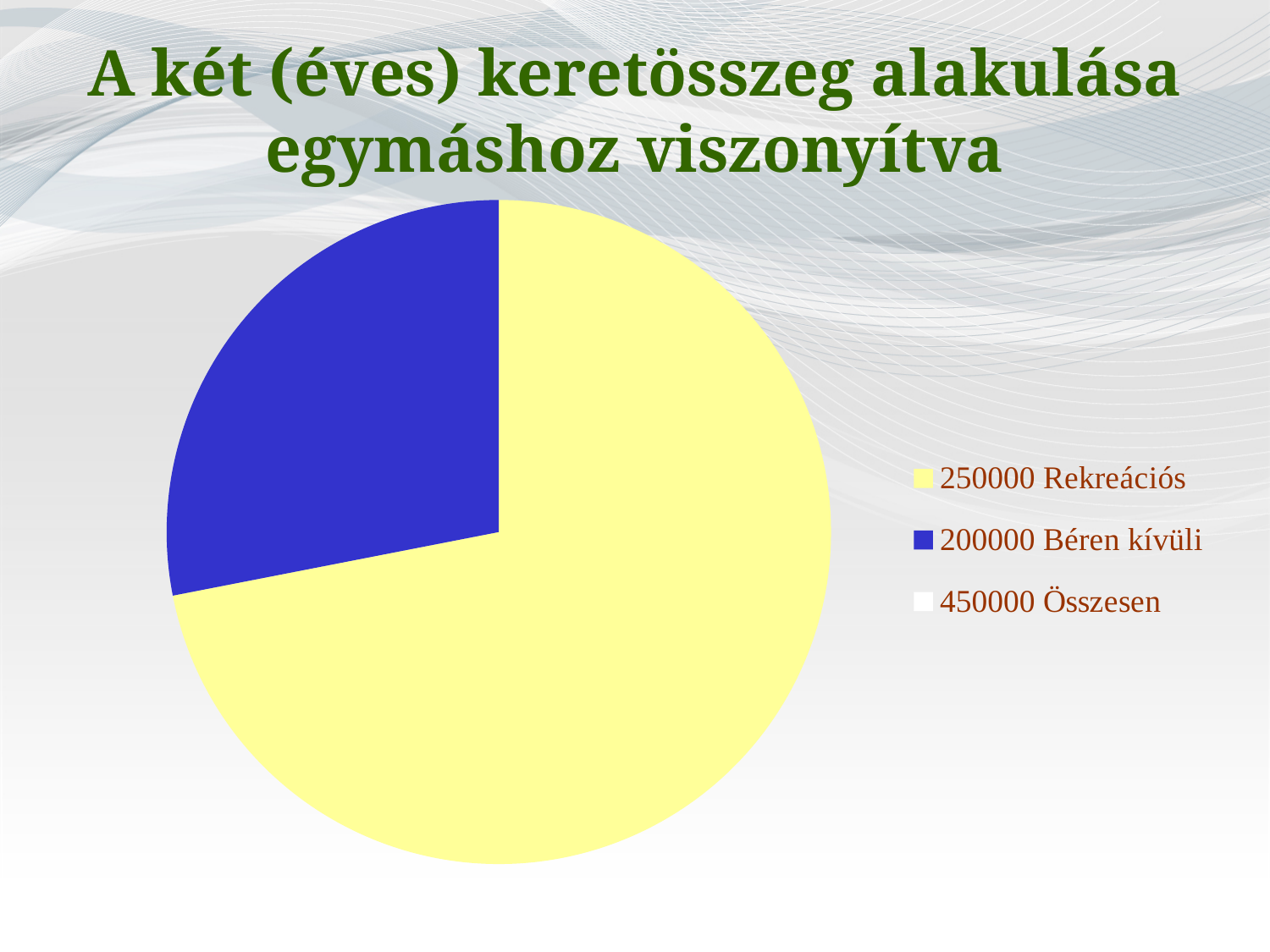
What colour is the Rekreációs slice? yellow What number is shown in the legend entry for Béren kívüli? 200000 What number is shown in the legend entry for Összesen? 450000 What kind of chart is shown on the slide? pie chart What number is shown in the legend entry for Rekreációs? 250000 How many entries does the legend list? 3 Which legend category has the largest visible slice in the pie? Rekreációs What is the difference between the Rekreációs value and the Béren kívüli value shown in the legend? 50000 Which slice of the pie is larger, Rekreációs or Béren kívüli? Rekreációs What colour is the Béren kívüli slice? blue